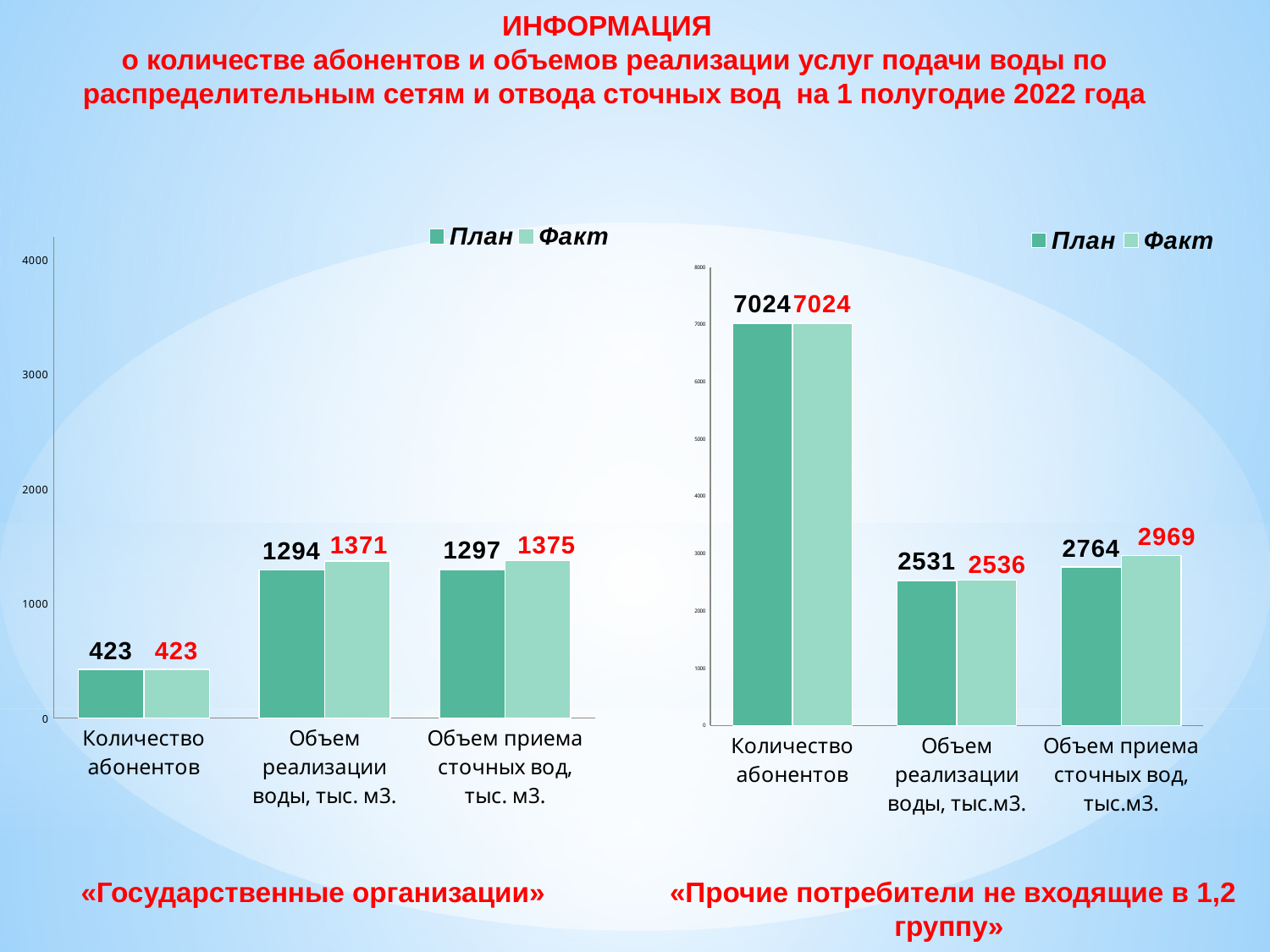
In the left chart («Государственные организации»), what is the Факт value for Объем приема сточных вод, тыс. м3? 1375 In the right chart («Прочие потребители не входящие в 1,2 группу»), what is the difference between the Факт and План values for Объем приема сточных вод, тыс.м3? 205 In the right chart («Прочие потребители не входящие в 1,2 группу»), which category has the highest Факт value? Количество абонентов In the left chart («Государственные организации»), what is the План value for Объем реализации воды, тыс. м3? 1294 In the right chart («Прочие потребители не входящие в 1,2 группу»), what is the Факт value for Объем приема сточных вод, тыс.м3? 2969 How many categories are shown on the x axis of the left chart («Государственные организации»)? 3 In the left chart («Государственные организации»), which category has the lowest План value? Количество абонентов In the left chart («Государственные организации»), is the Факт value for Объем приема сточных вод larger or smaller than the Факт value for Объем реализации воды? larger In the right chart («Прочие потребители не входящие в 1,2 группу»), what is the План value for Количество абонентов? 7024 How many series does the legend of the right chart («Прочие потребители не входящие в 1,2 группу») list? 2 In the left chart («Государственные организации»), what is the difference between the Факт and План values for Объем реализации воды, тыс. м3? 77 What type of chart is the left chart («Государственные организации»)? bar chart